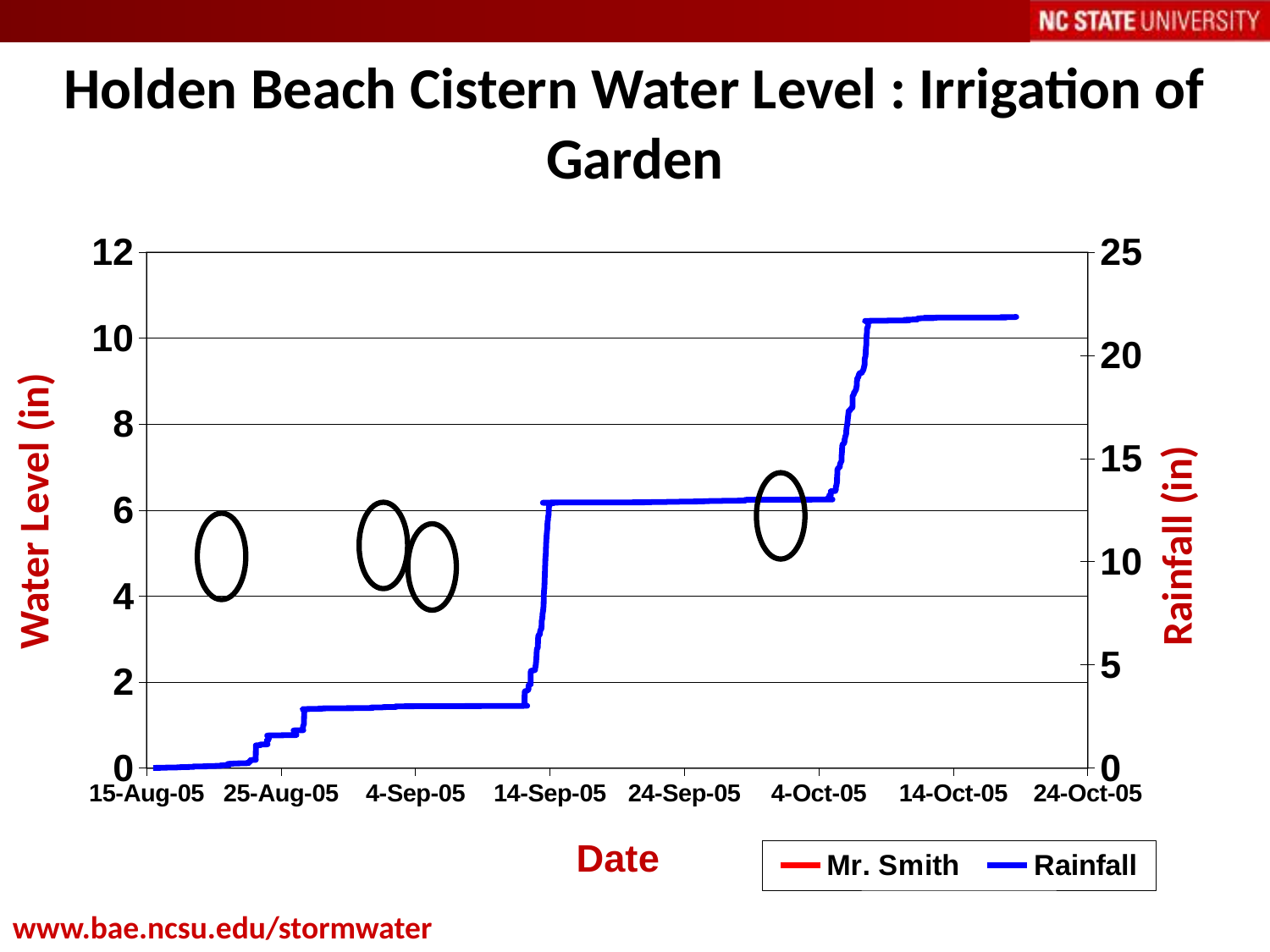
How many series does the legend list? 2 Is the Rainfall value at 14-Oct-05 greater or less than 15 on the right-hand Rainfall (in) axis? greater Is the Rainfall value at 4-Sep-05 greater or less than 5 on the right-hand Rainfall (in) axis? less What are the two series names listed in the chart legend? Mr. Smith and Rainfall Is the Rainfall value at 24-Sep-05 greater or less than 10 on the right-hand Rainfall (in) axis? greater What kind of chart is shown on the slide? line chart Do the plotted Rainfall values rise or fall along the x axis from 15-Aug-05 to 24-Oct-05? rise What is the title of the chart on the slide? Holden Beach Cistern Water Level : Irrigation of Garden